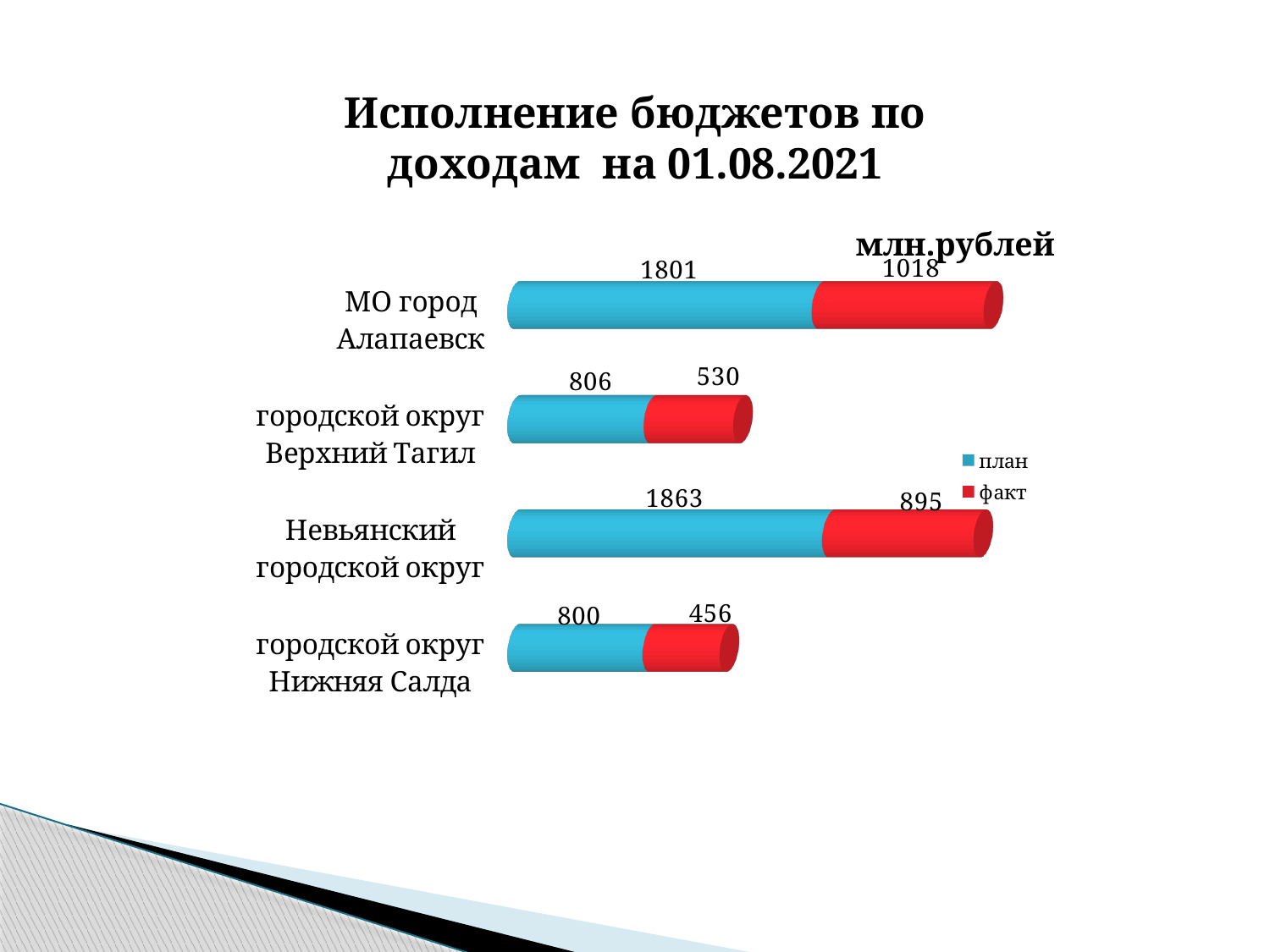
What is the план value for городской округ Нижняя Салда? 800 Which is larger: the факт value for Невьянский городской округ or the факт value for городской округ Верхний Тагил? Невьянский городской округ What is the difference between the план and факт values for МО город Алапаевск? 783 What is the факт value for городской округ Верхний Тагил? 530 What is the план value for Невьянский городской округ? 1863 What is the total of the stacked bar for городской округ Нижняя Салда? 1256 What is the факт value for МО город Алапаевск? 1018 Which category has the highest план value? Невьянский городской округ How many series does the legend list? 2 How many categories are shown in the chart? 4 What kind of chart is shown on the slide? Stacked bar chart Which category has the lowest факт value? городской округ Нижняя Салда